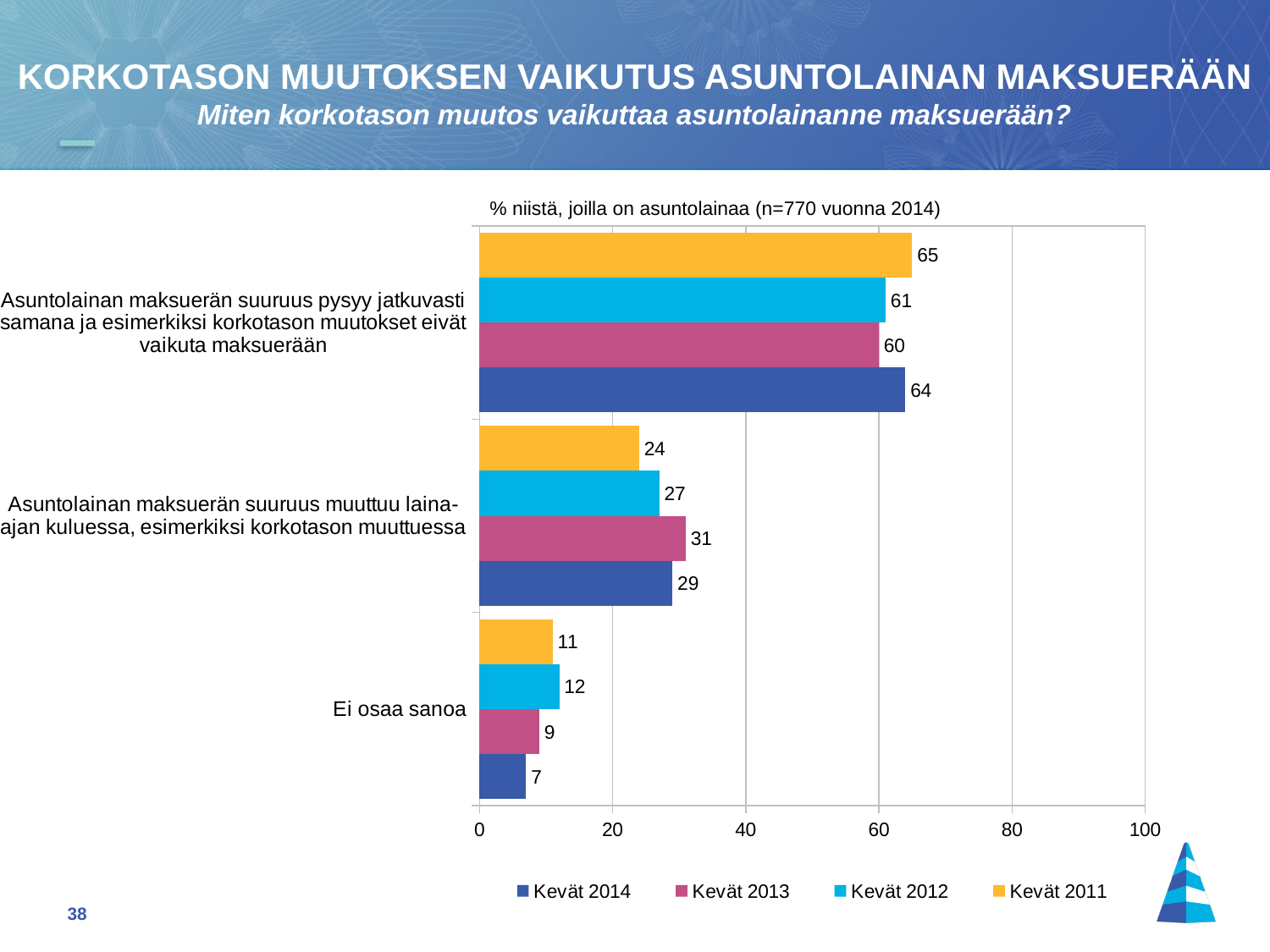
How many categories are shown on the chart? 3 For 'Ei osaa sanoa', which is larger: the Kevät 2012 value or the Kevät 2013 value? Kevät 2012 What is the Kevät 2011 value for 'Asuntolainan maksuerän suuruus pysyy jatkuvasti samana ja esimerkiksi korkotason muutokset eivät vaikuta maksuerään'? 65 What is the difference between the Kevät 2014 and Kevät 2013 values for 'Asuntolainan maksuerän suuruus pysyy jatkuvasti samana ja esimerkiksi korkotason muutokset eivät vaikuta maksuerään'? 4 What is the text shown above the chart describing the base of respondents? % niistä, joilla on asuntolainaa (n=770 vuonna 2014) Is the Kevät 2014 value for 'Asuntolainan maksuerän suuruus pysyy jatkuvasti samana ja esimerkiksi korkotason muutokset eivät vaikuta maksuerään' greater or less than 60? greater What is the Kevät 2014 value for 'Ei osaa sanoa'? 7 How many series does the legend list? 4 Which series has the lowest value for 'Ei osaa sanoa'? Kevät 2014 What kind of chart is shown on the slide? Bar chart What is the Kevät 2013 value for 'Asuntolainan maksuerän suuruus muuttuu laina-ajan kuluessa, esimerkiksi korkotason muuttuessa'? 31 Which series has the highest value for 'Asuntolainan maksuerän suuruus muuttuu laina-ajan kuluessa, esimerkiksi korkotason muuttuessa'? Kevät 2013